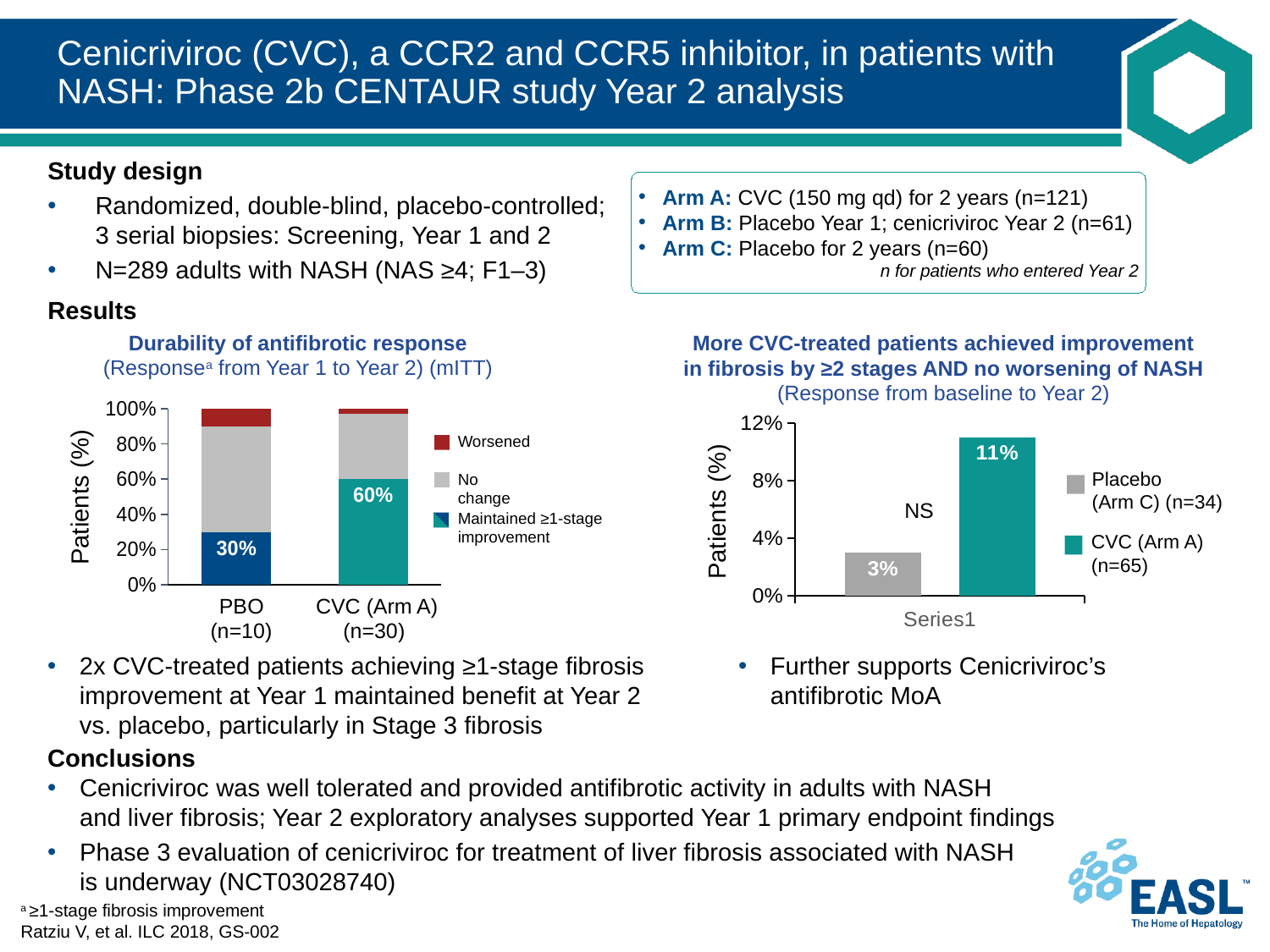
How many groups are shown on the x axis of the 'Durability of antifibrotic response' chart? 2 In the chart on the right, which group has the highest value? CVC (Arm A) In the 'Durability of antifibrotic response' chart, what percentage of CVC (Arm A) (n=30) patients maintained ≥1-stage improvement? 60% In the chart on the right, what is the difference between the CVC (Arm A) and Placebo (Arm C) values? 8% In the 'Durability of antifibrotic response' chart, what is the difference between the CVC (Arm A) and PBO values for maintained ≥1-stage improvement? 30% How many series does the legend of the 'Durability of antifibrotic response' chart list? 3 How many series does the legend of the chart on the right list? 2 In the chart on the right ('More CVC-treated patients achieved improvement in fibrosis by ≥2 stages AND no worsening of NASH'), what is the value for Placebo (Arm C) (n=34)? 3% In the 'Durability of antifibrotic response' chart, what percentage of PBO (n=10) patients maintained ≥1-stage improvement? 30% In the 'Durability of antifibrotic response' chart, which group has the larger share of patients who maintained ≥1-stage improvement, PBO or CVC (Arm A)? CVC (Arm A) What kind of chart is the 'Durability of antifibrotic response' chart? Stacked bar chart In the chart on the right, what is the value for CVC (Arm A) (n=65)? 11%